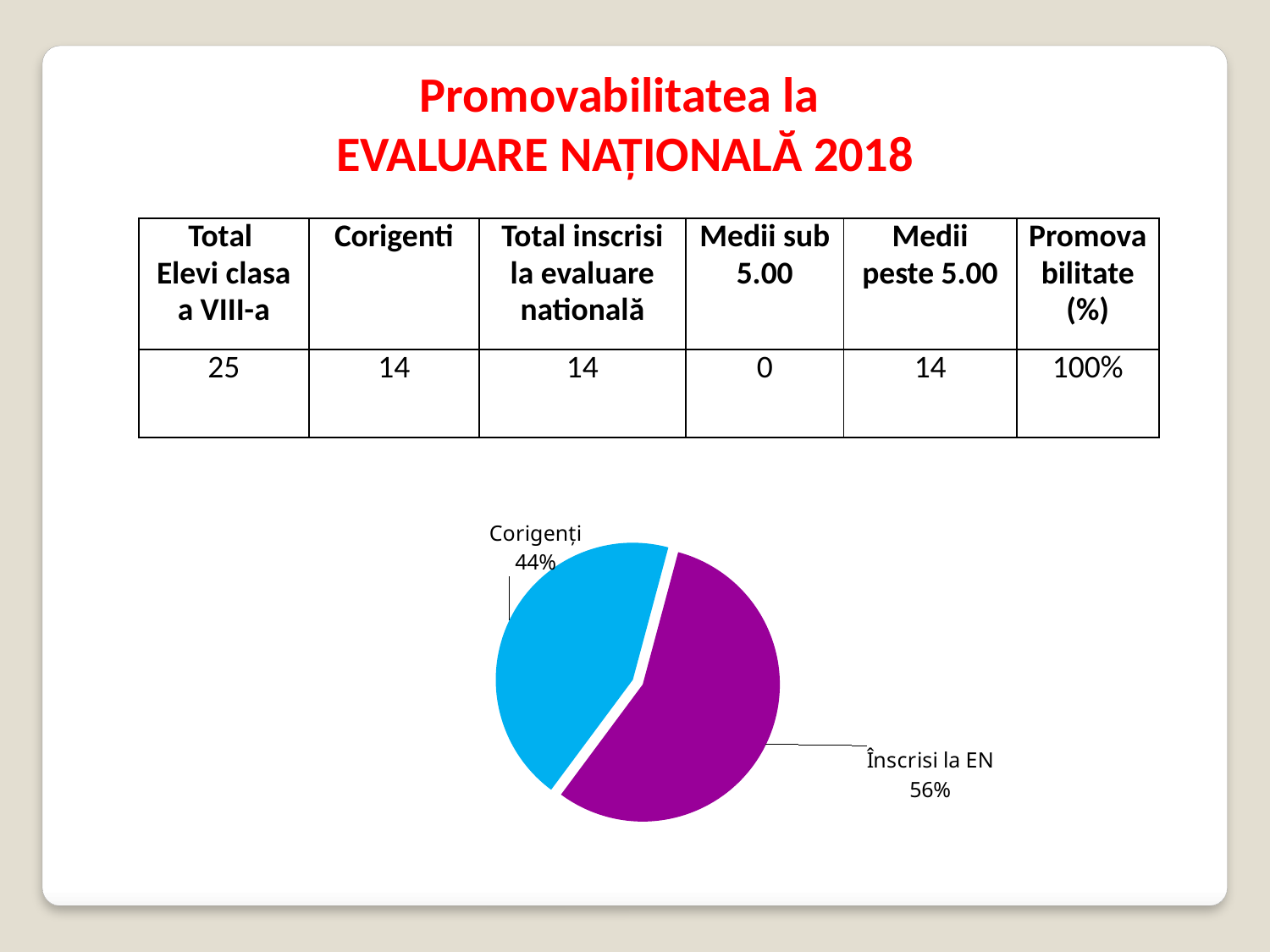
What is the difference in percentage points between the Înscrisi la EN slice and the Corigenți slice? 12% Which slice of the pie chart is the smallest? Corigenți What share of the pie does the Înscrisi la EN slice represent? 56% Is the share for Corigenți greater or less than 50%? less What colour is the Corigenți slice in the pie chart? blue How many slices does the pie chart have? 2 What colour is the Înscrisi la EN slice in the pie chart? purple What share of the pie does the Corigenți slice represent? 44% Which is larger in the pie chart, Corigenți or Înscrisi la EN? Înscrisi la EN Which slice of the pie chart is the largest? Înscrisi la EN What type of chart is shown on the slide? pie chart